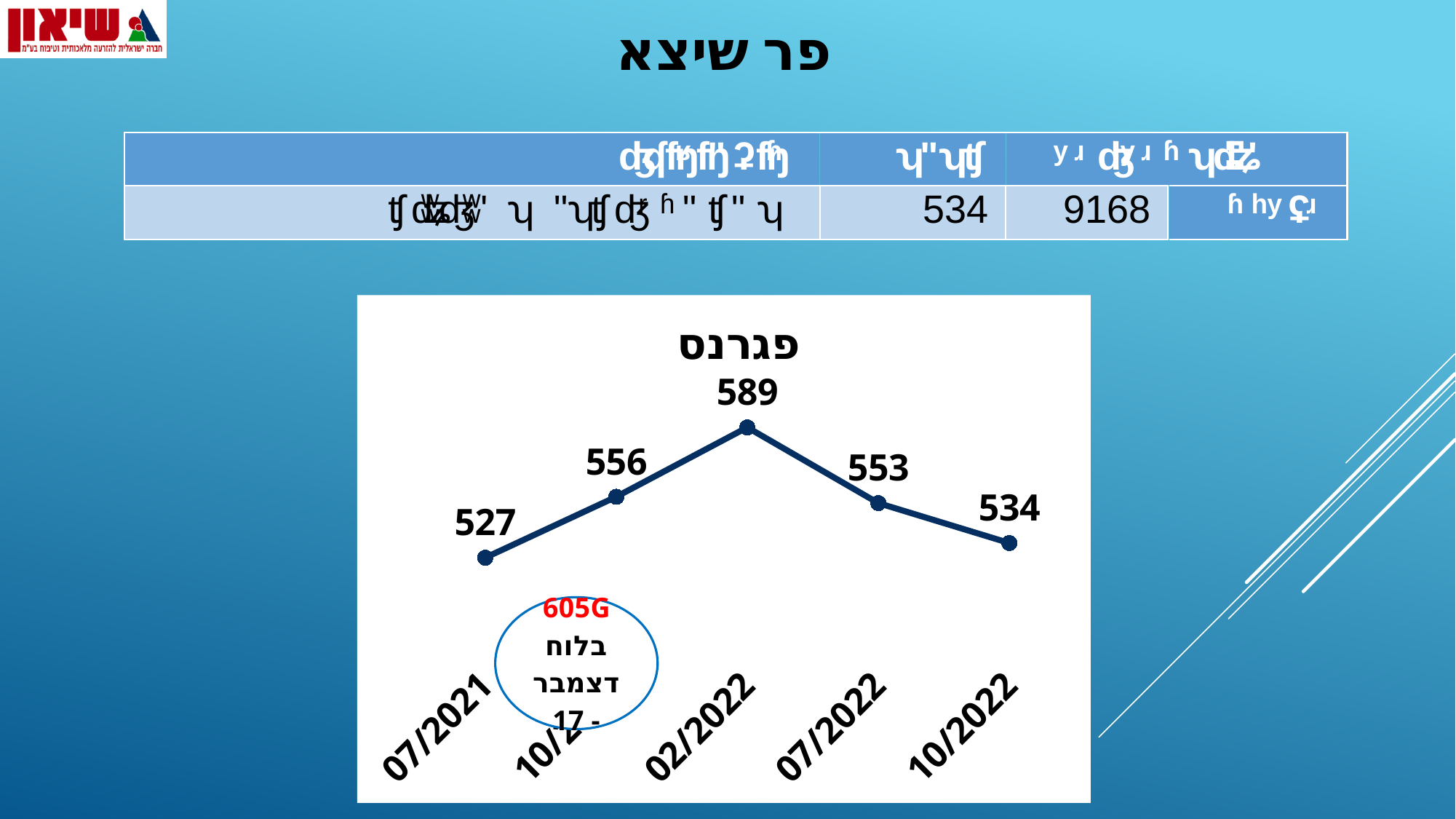
What is the value for 07/2021? 527 Does the value rise or fall from 02/2022 to 10/2022? fall How many data points are plotted on the line? 5 Which is larger, the value for 07/2022 or the value for 10/2022? 07/2022 What is the value for 10/2022? 534 Which period has the lowest value? 07/2021 What is the chart's title? פגרנס What is the value for 07/2022? 553 Which period has the highest value? 02/2022 What is the value for 02/2022? 589 What type of chart is shown on the slide? line chart What is the difference between the values for 02/2022 and 10/2022? 55